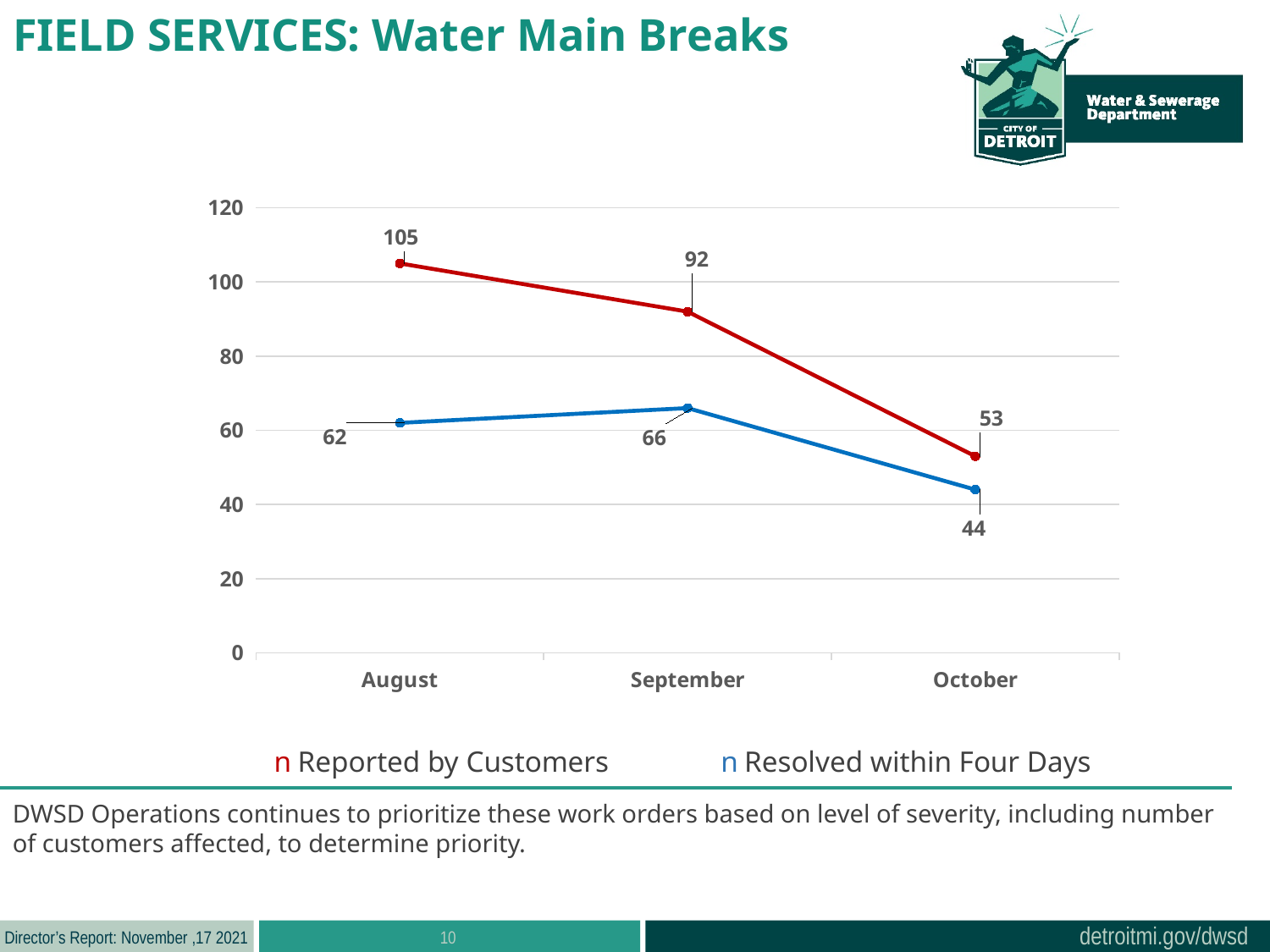
Which colour is used for the Resolved within Four Days series? blue What is the value for Reported by Customers in October? 53 In which month is the Reported by Customers value highest? August What is the value for Reported by Customers in August? 105 How many months are plotted on the x axis? 3 What kind of chart is shown on the slide? line chart In which month is the Resolved within Four Days value lowest? October What is the difference between Reported by Customers and Resolved within Four Days in September? 26 Which is larger in October: Reported by Customers or Resolved within Four Days? Reported by Customers What is the value for Resolved within Four Days in September? 66 How many series does the legend list? 2 Does the Reported by Customers series rise or fall from August to October? fall